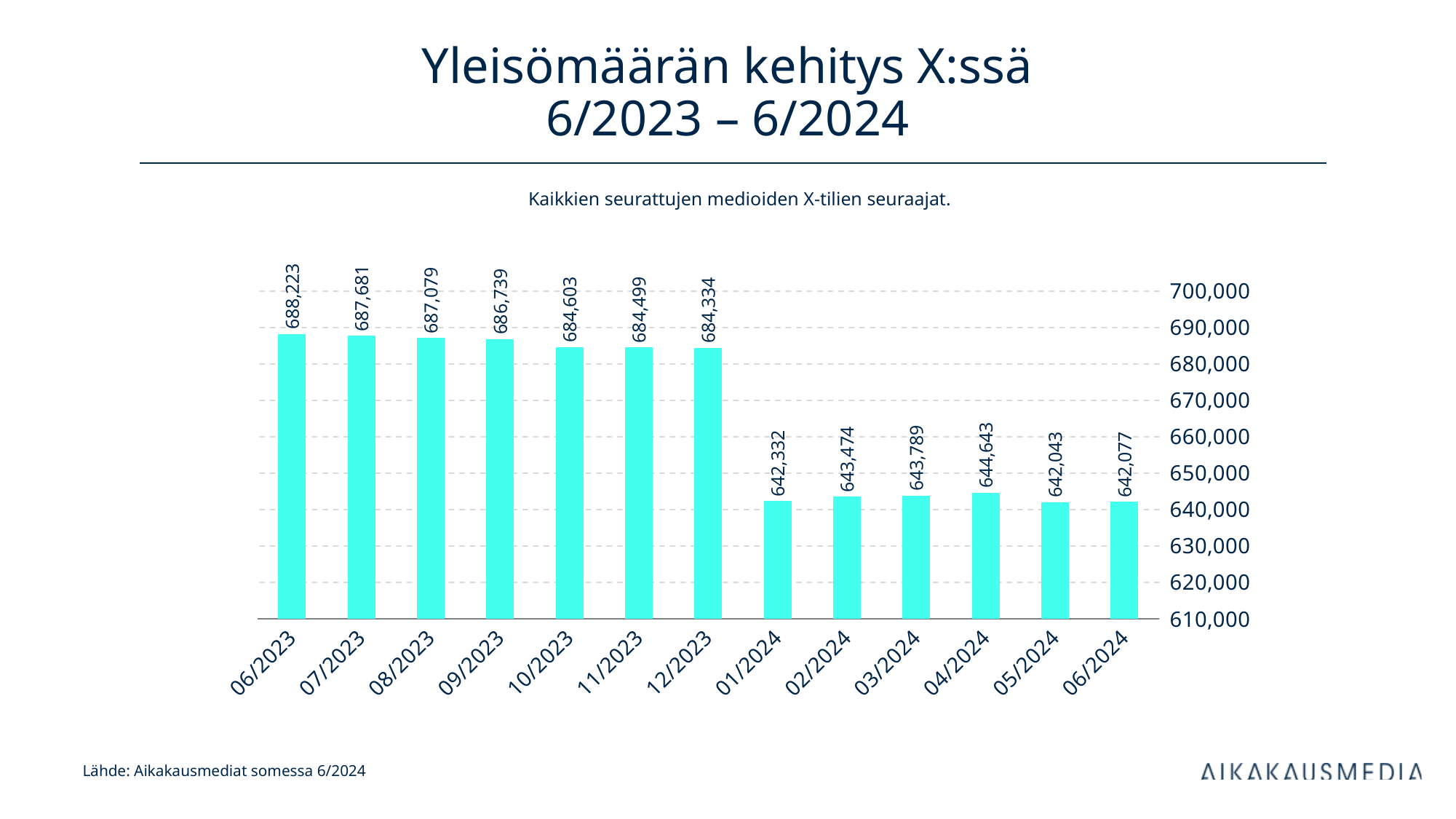
How many months are shown on the x axis? 13 What is the difference between the values for 12/2023 and 01/2024? 42,002 Which month has the lowest value? 05/2024 Which month has the highest value? 06/2023 What kind of chart is shown on the slide? bar chart What is the difference between the values for 06/2023 and 06/2024? 46,146 Do the values generally rise or fall from 06/2023 to 06/2024? fall What is the value for 01/2024? 642,332 What is the value for 04/2024? 644,643 What is the value for 06/2023? 688,223 Which is larger, the value for 09/2023 or the value for 10/2023? 09/2023 Is the value for 03/2024 greater or less than 650,000? less